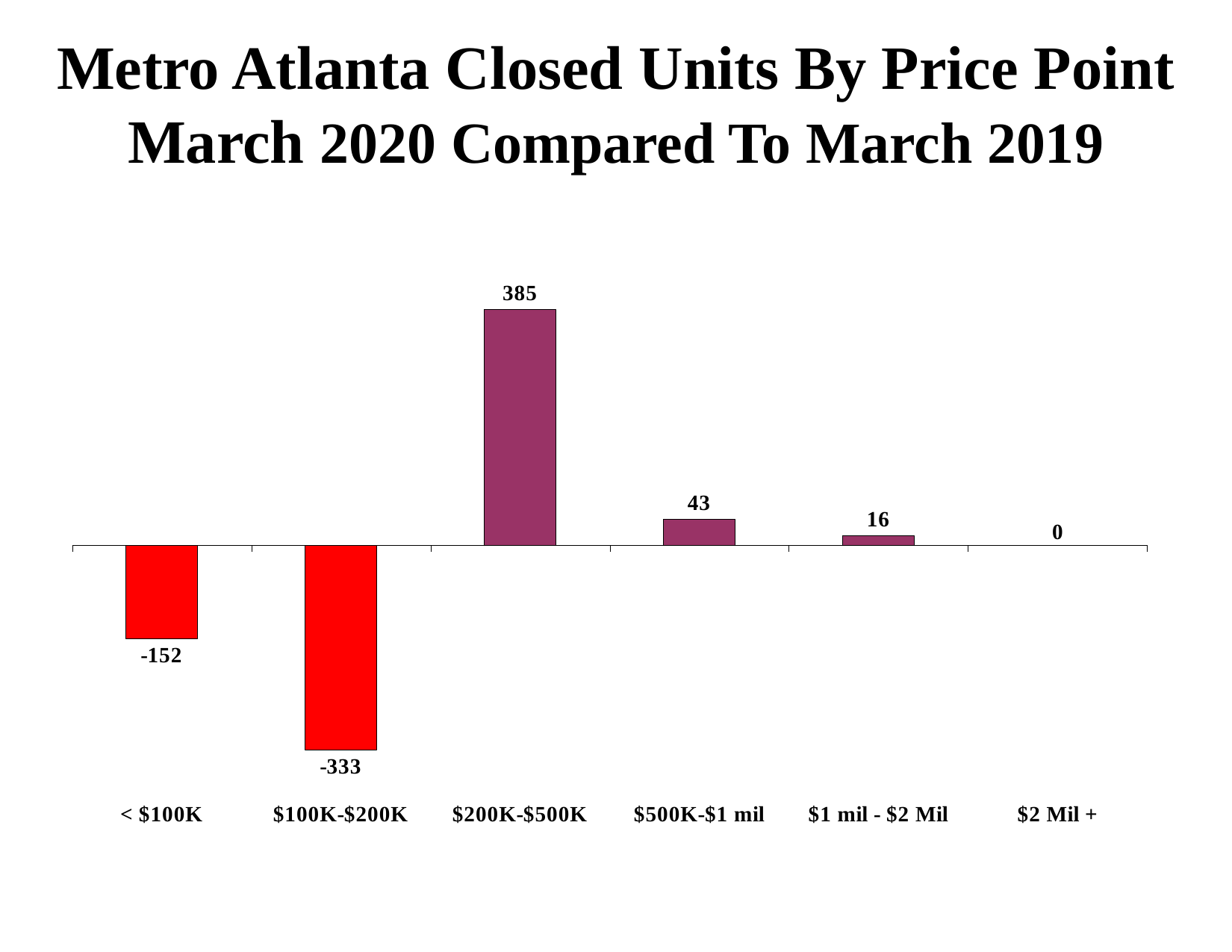
Which is larger, the value for $500K-$1 mil or the value for $1 mil - $2 Mil? $500K-$1 mil What is the value for the $200K-$500K price point? 385 What is the value for the $1 mil - $2 Mil price point? 16 How many price point categories are shown on the chart? 6 What is the value for the $2 Mil + price point? 0 Which price point has the lowest value? $100K-$200K What is the value for the $100K-$200K price point? -333 What colour are the bars with negative values? Red What is the difference between the values for $200K-$500K and $500K-$1 mil? 342 What is the value for the < $100K price point? -152 Which price point has the highest value? $200K-$500K What kind of chart is shown on the slide? Bar chart